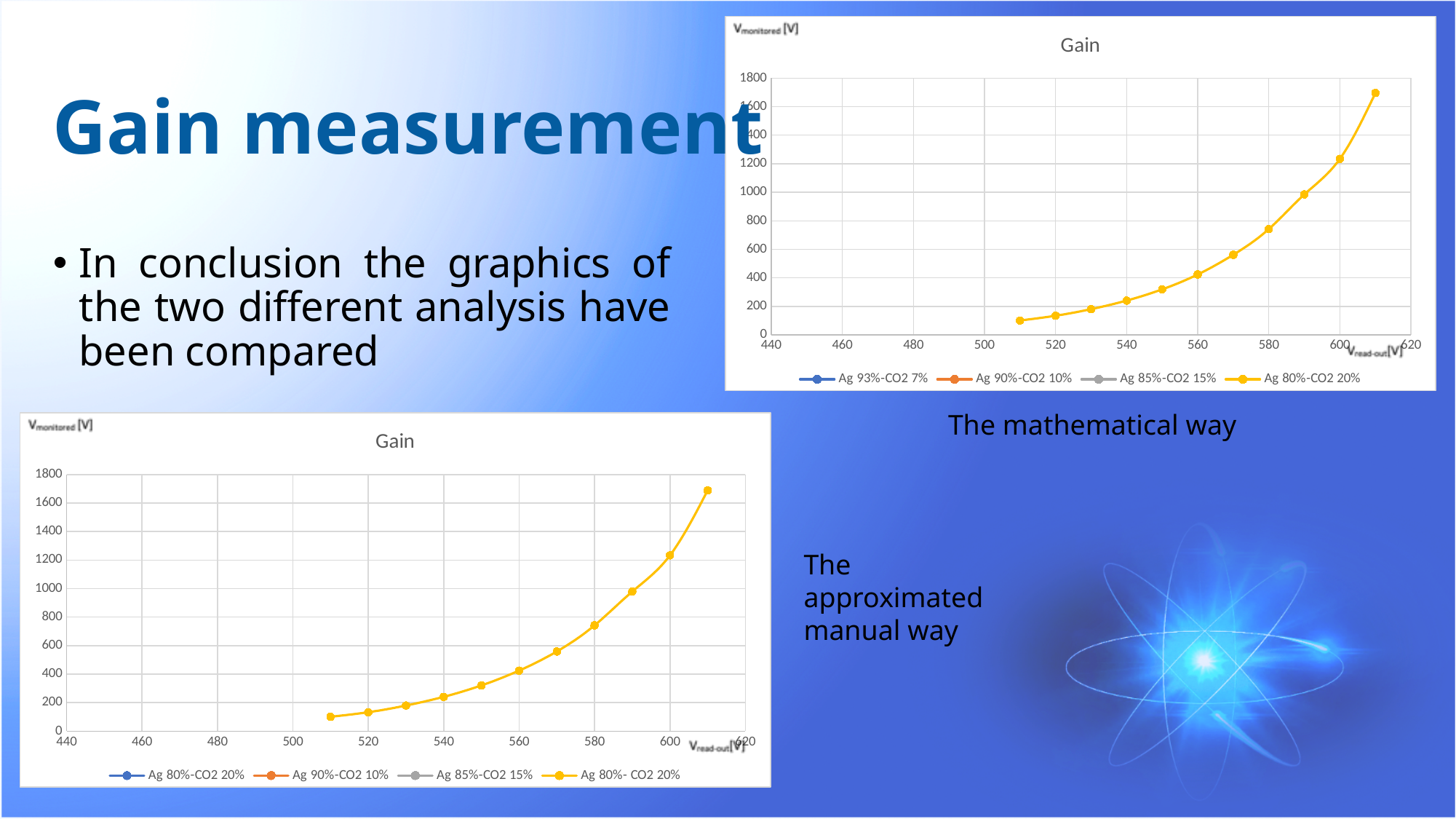
In the top-right 'Gain' chart, do the values rise or fall as V read-out increases along the x axis? rise In the top-right 'Gain' chart, is the value at V read-out 510 greater or less than 200? less In the bottom-left 'Gain' chart, which has the larger value: V read-out 580 or V read-out 540? 580 In the bottom-left 'Gain' chart, at which V read-out value is the plotted value lowest? 510 What kind of chart is the top-right chart titled 'Gain'? line chart In the bottom-left 'Gain' chart, how many series does the legend list? 4 In the top-right 'Gain' chart, at which V read-out value is the plotted value highest? 610 How many series does the legend of the top-right 'Gain' chart list? 4 What is the last legend entry of the top-right 'Gain' chart? Ag 80%-CO2 20% In the top-right 'Gain' chart, is the value at V read-out 610 greater or less than 1600? greater In the top-right 'Gain' chart, how many data points are plotted on the yellow line? 11